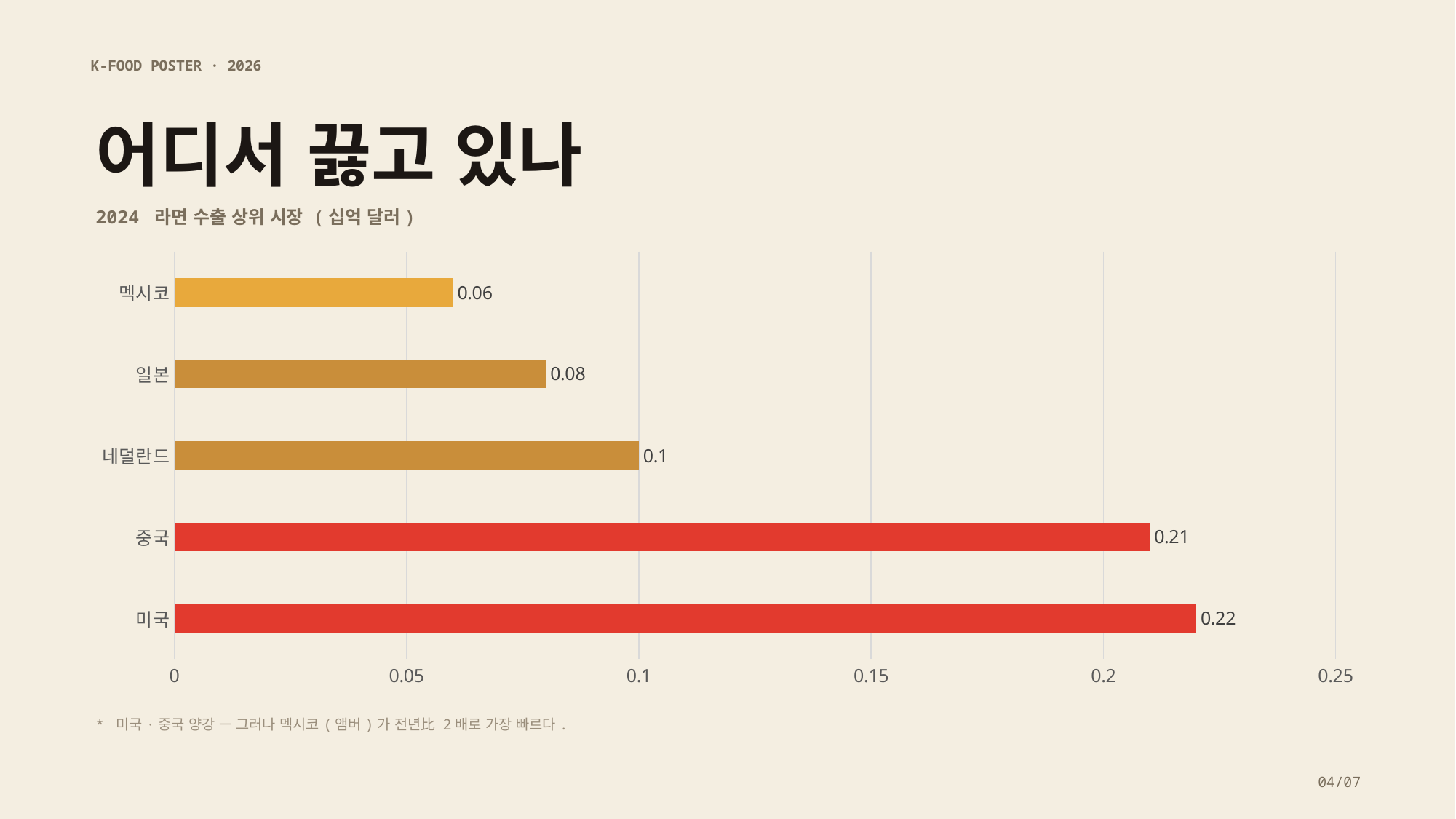
Which category has the lowest value? 멕시코 What kind of chart is shown on the slide? bar chart How many categories are shown in the chart? 5 Which is larger, the value for 네덜란드 or the value for 일본? 네덜란드 What is the value for 멕시코? 0.06 What is the value for 일본? 0.08 What is the value for 네덜란드? 0.1 What is the value for 미국? 0.22 What is the value for 중국? 0.21 What is the difference between the values for 미국 and 멕시코? 0.16 Which category has the highest value? 미국 Is the value for 중국 greater or less than 0.15? greater